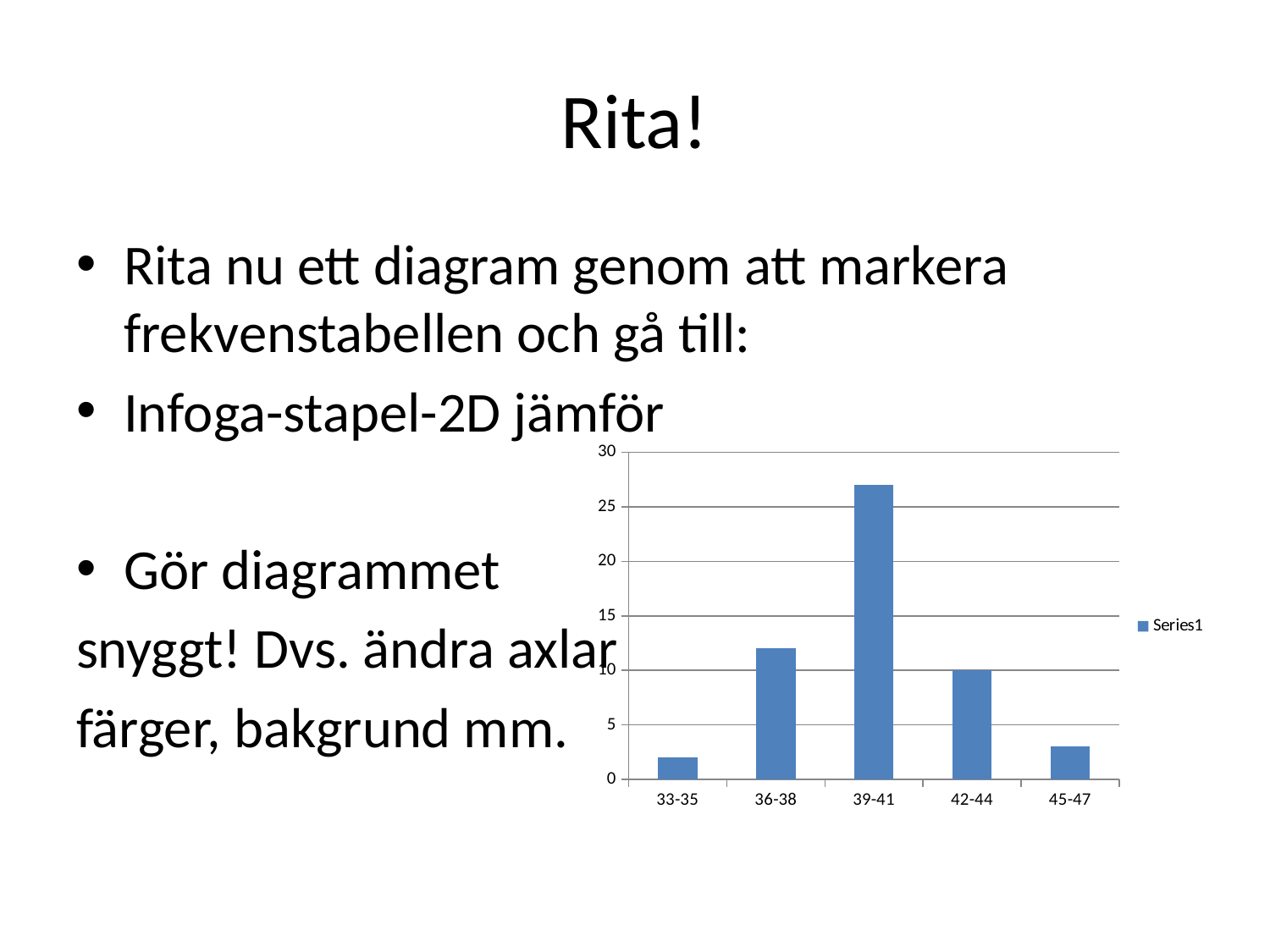
Is the value for 33-35 greater or less than 5? less Which category has the highest bar in the chart? 39-41 Which is larger, the value for 45-47 or the value for 33-35? 45-47 What is the name of the series shown in the chart legend? Series1 Is the value for 36-38 greater or less than 10? greater Which is larger, the value for 36-38 or the value for 42-44? 36-38 Is the value for 39-41 greater or less than 25? greater What kind of chart is shown on the slide? bar chart How many series does the chart legend list? 1 Which category has the lowest bar in the chart? 33-35 How many categories are shown on the x axis of the chart? 5